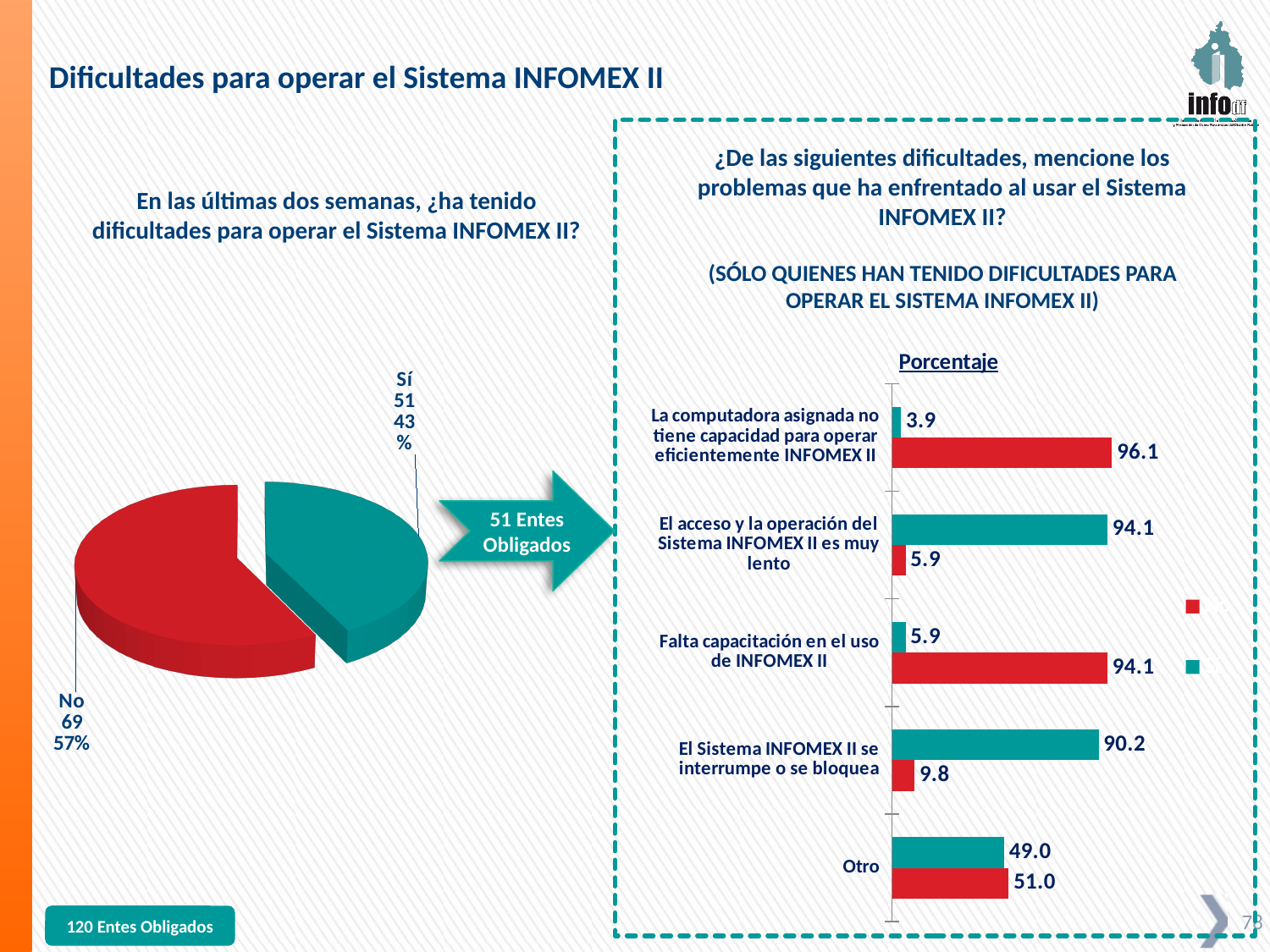
In the bar chart on the right, what is the difference between the red bar and the teal bar for "Otro"? 2.0 In the pie chart on the left, what percentage is shown for "No"? 57% In the pie chart on the left, what percentage is shown for "Sí"? 43% In the pie chart on the left, which slice is larger, "Sí" or "No"? No In the bar chart on the right, which category has the highest red bar value? La computadora asignada no tiene capacidad para operar eficientemente INFOMEX II In the bar chart on the right, what is the value of the red bar for "Otro"? 51.0 In the bar chart on the right, for "El Sistema INFOMEX II se interrumpe o se bloquea", which bar is larger, the teal bar or the red bar? The teal bar In the bar chart on the right, what is the value of the red bar for "La computadora asignada no tiene capacidad para operar eficientemente INFOMEX II"? 96.1 What kind of chart is the chart on the left of the slide? Pie chart How many series does the legend of the bar chart on the right list? 2 In the bar chart on the right, what is the value of the teal bar for "El acceso y la operación del Sistema INFOMEX II es muy lento"? 94.1 How many categories are shown in the bar chart on the right? 5